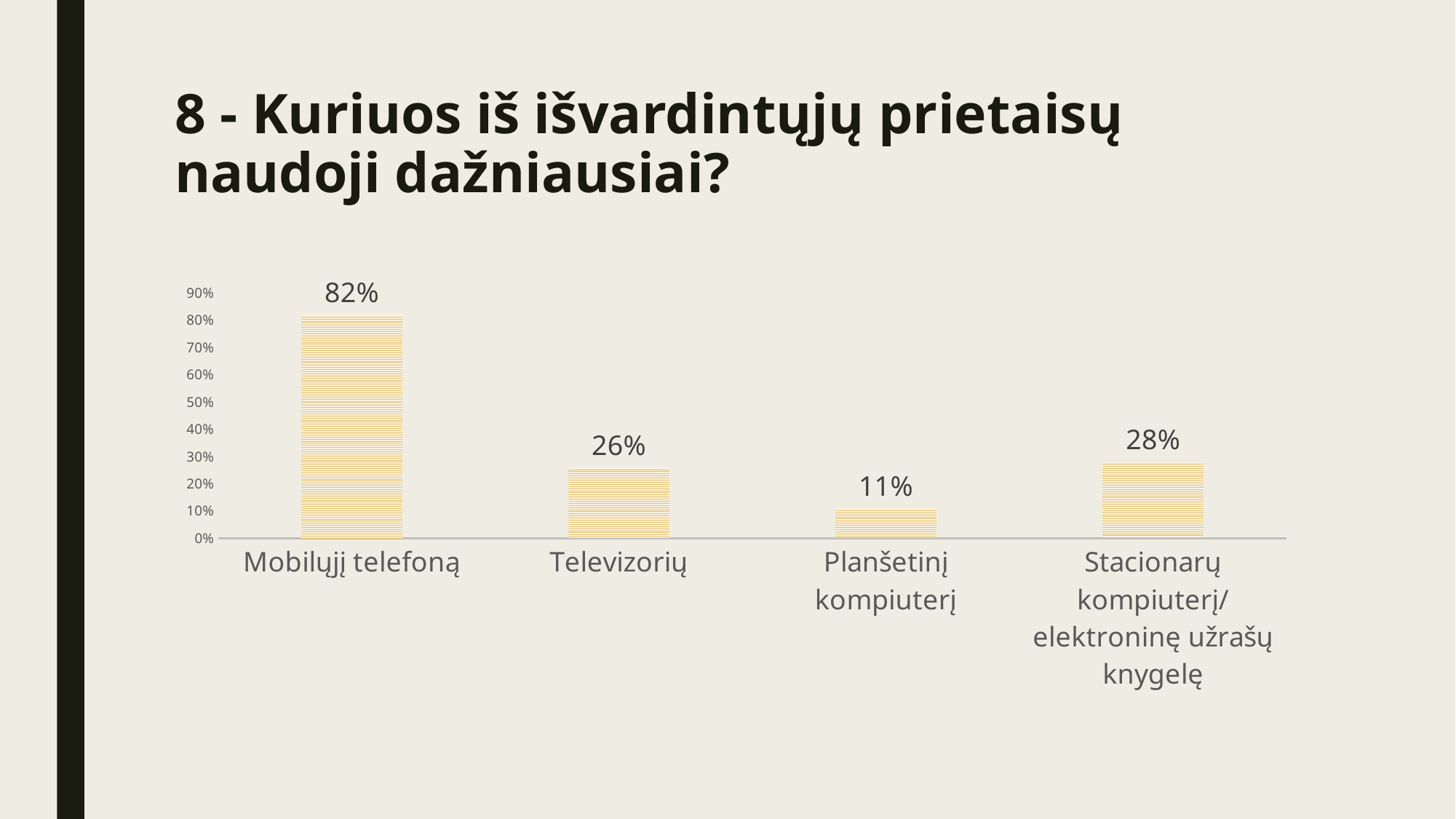
What kind of chart is shown on the slide? bar chart What is the value for Mobilųjį telefoną? 82% Which category has the lowest value? Planšetinį kompiuterį Is the value for Mobilųjį telefoną greater or less than 50%? greater Which is larger, the value for Televizorių or the value for Stacionarų kompiuterį/ elektroninę užrašų knygelę? Stacionarų kompiuterį/ elektroninę užrašų knygelę What is the value for Stacionarų kompiuterį/ elektroninę užrašų knygelę? 28% What is the value for Televizorių? 26% What is the difference between the values for Mobilųjį telefoną and Televizorių? 56% Which category has the highest value? Mobilųjį telefoną How many categories are shown in the chart? 4 What is the value for Planšetinį kompiuterį? 11% What is the difference between the values for Stacionarų kompiuterį/ elektroninę užrašų knygelę and Planšetinį kompiuterį? 17%